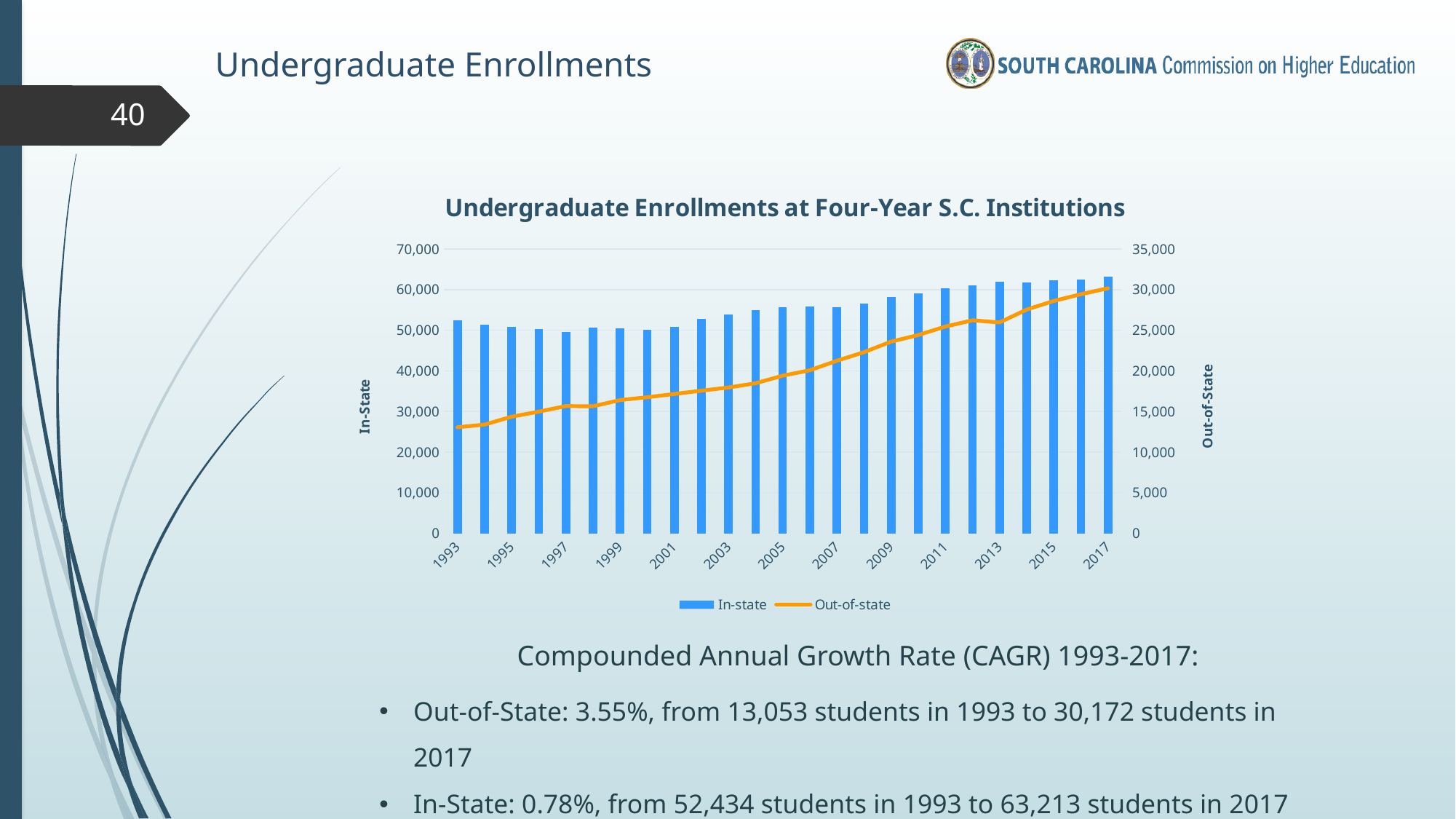
How many years (bars) are plotted in the chart? 25 How many series does the chart legend list? 2 What was the Out-of-state undergraduate enrollment in 2017? 30,172 Is the In-state enrollment for 2017 greater or less than 60,000? greater What is the title of the chart? Undergraduate Enrollments at Four-Year S.C. Institutions Is the Out-of-state enrollment for 2001 greater or less than 20,000? less What was the In-state undergraduate enrollment in 1993? 52,434 What kind of chart is shown on the slide? A bar chart combined with a line chart Which series is shown as an orange line in the chart? Out-of-state Does the Out-of-state enrollment line generally rise or fall from 1993 to 2017? Rise By how much did Out-of-state enrollment increase from 1993 to 2017? 17,119 By how much did In-state enrollment increase from 1993 to 2017? 10,779